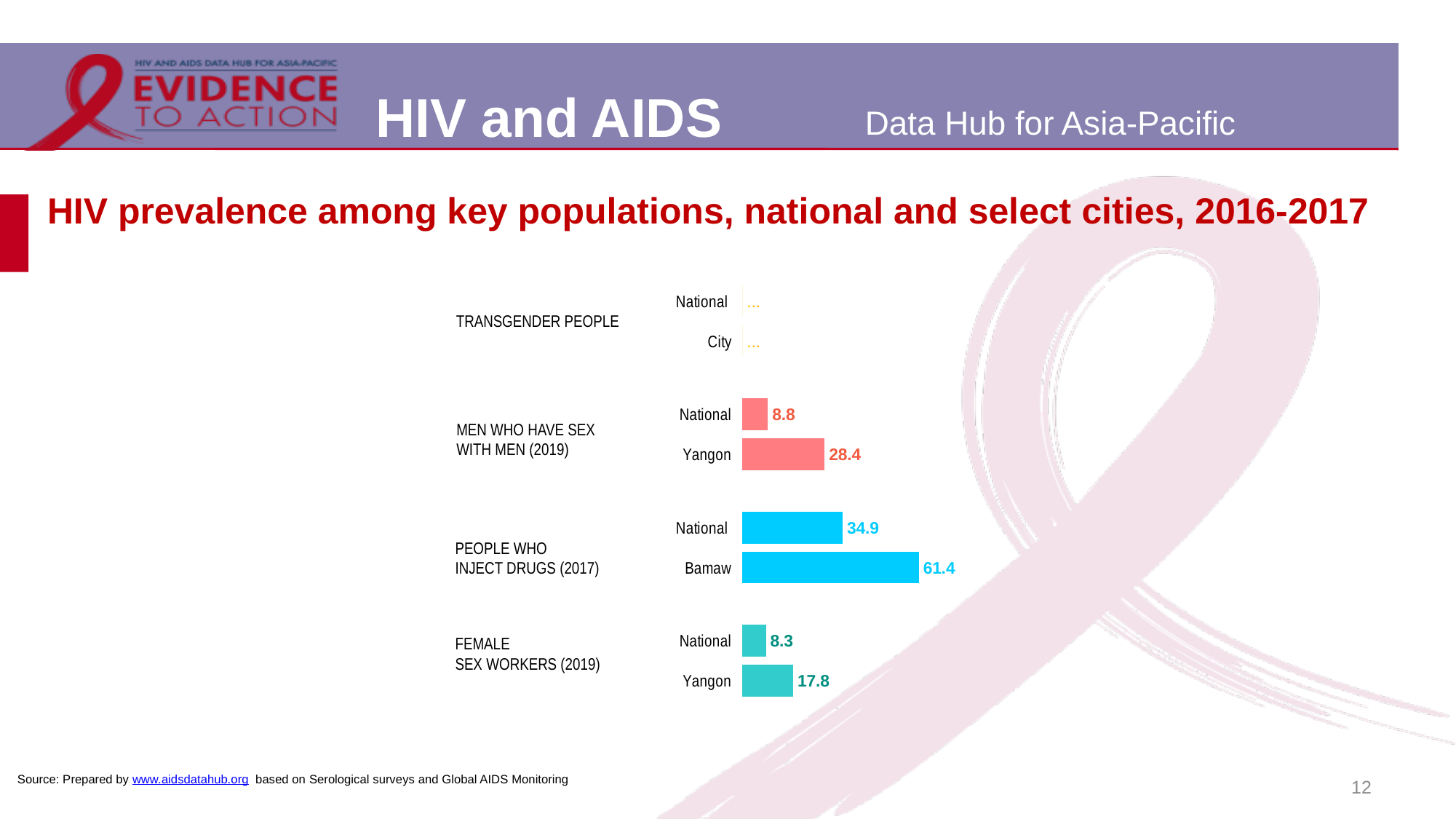
What values are shown for transgender people on the chart? ... (no data) What is the difference between the Yangon and national HIV prevalence among female sex workers? 9.5 What is the difference between the Bamaw and national HIV prevalence among people who inject drugs? 26.5 What is the national HIV prevalence among female sex workers (2019)? 8.3 What is the HIV prevalence among men who have sex with men in Yangon? 28.4 Which bar shows the highest HIV prevalence on the chart? People who inject drugs, Bamaw What is the HIV prevalence among people who inject drugs in Bamaw? 61.4 What is the national HIV prevalence among men who have sex with men (2019)? 8.8 Which key population has the lowest national HIV prevalence value shown? Female sex workers How many key population groups are shown on the chart? 4 Which is larger: the Yangon HIV prevalence among men who have sex with men or the national HIV prevalence among people who inject drugs? National HIV prevalence among people who inject drugs What type of chart is shown on the slide? Bar chart